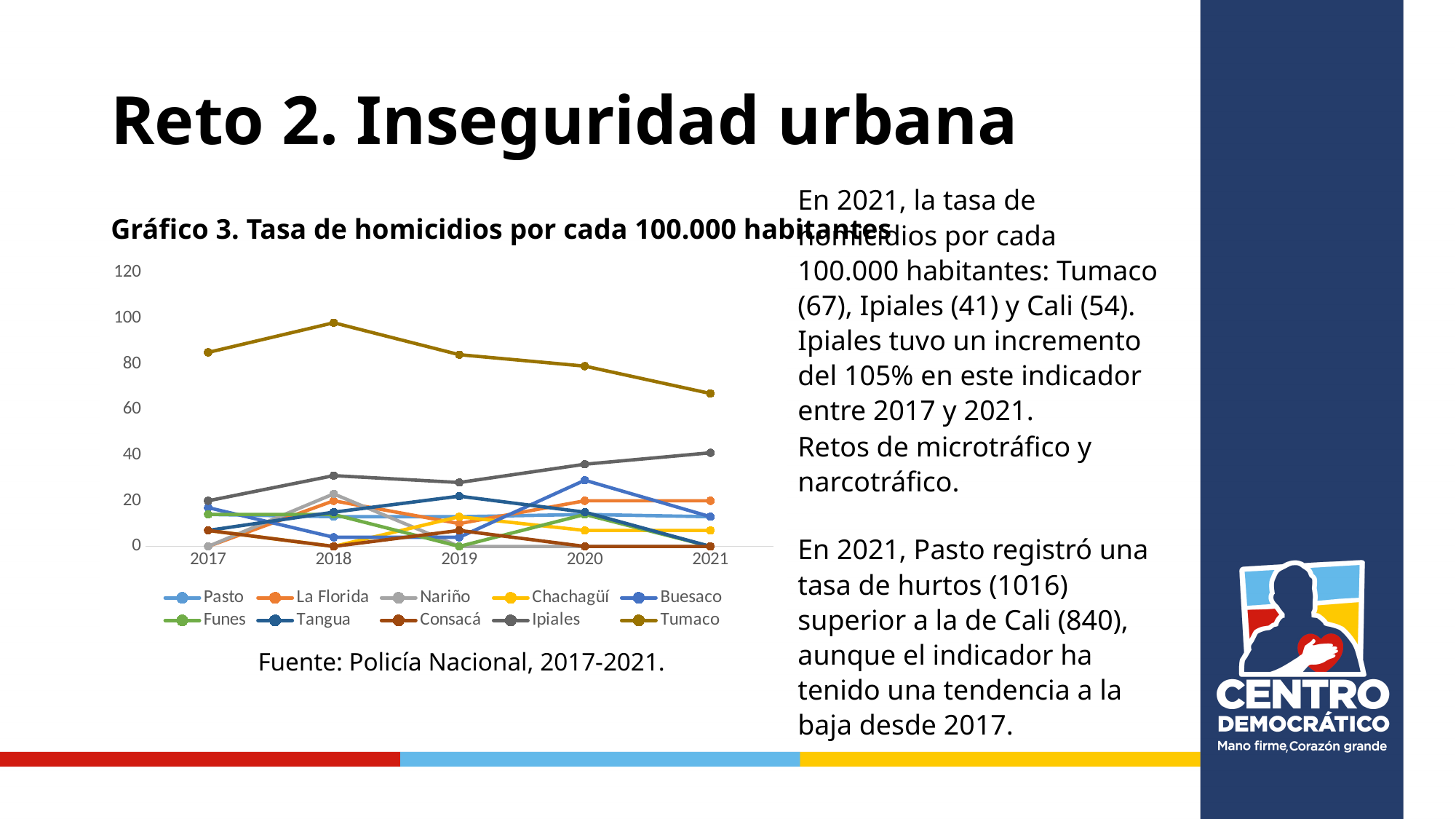
Does the Tumaco line rise or fall from 2018 to 2021? fall How many series does the legend of the chart list? 10 In 2020, which is higher: Tumaco or Ipiales? Tumaco What kind of chart is shown on the slide? line chart Is the value for Ipiales in 2021 greater or less than 20? greater How many years are shown on the x axis of the chart? 5 Does the Ipiales line rise or fall from 2017 to 2021? rise Is the value for Tumaco in 2018 greater or less than 80? greater Which series has the highest homicide rate in 2018? Tumaco Which series has the highest homicide rate in 2021? Tumaco Is the value for Tumaco in 2021 greater or less than 60? greater